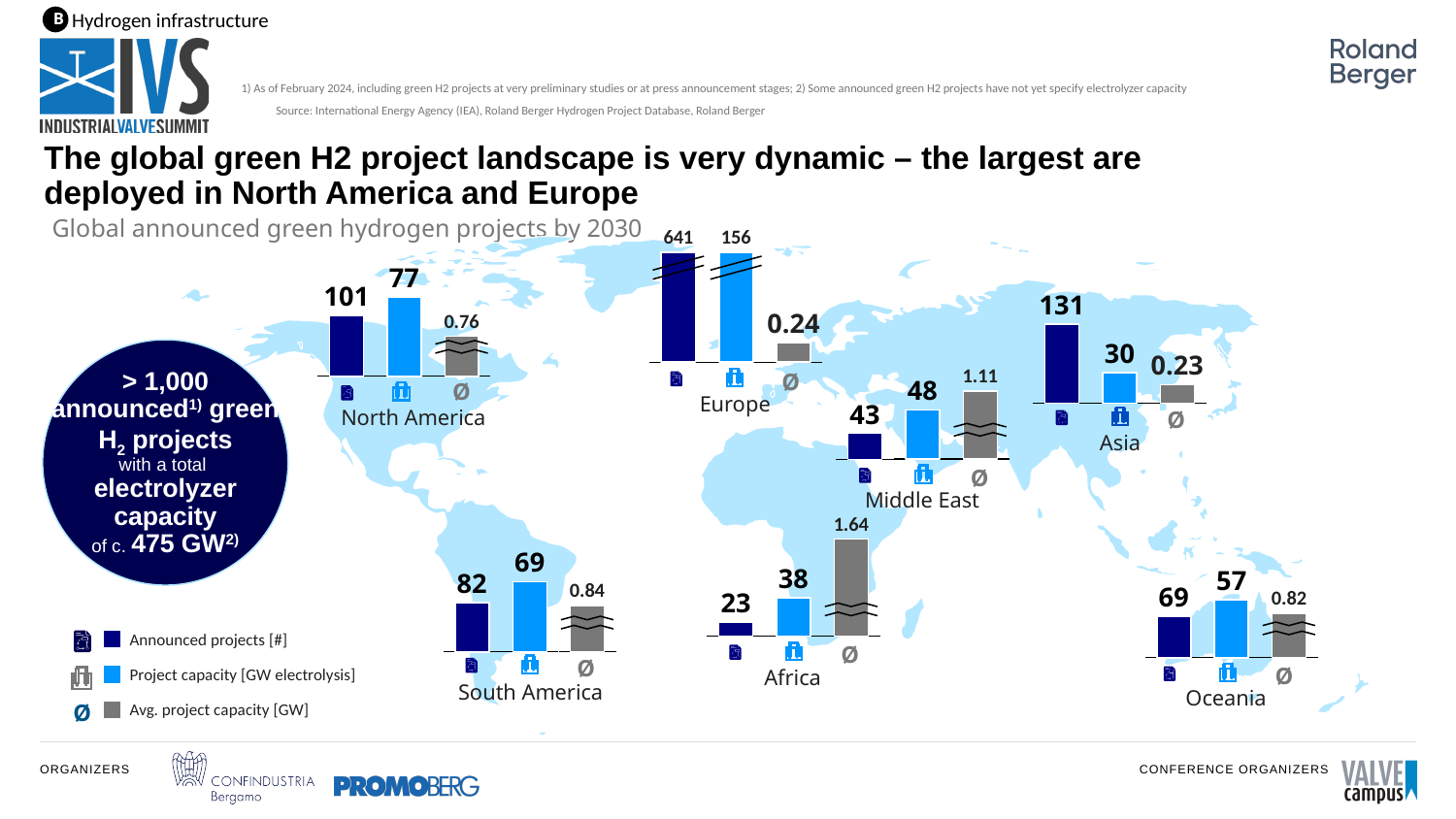
How many regions have their own bar chart on the map? 7 What is the average project capacity in GW shown for Africa? 1.64 How many series does the legend list? 3 Which region has the lowest number of announced projects? Africa Which region has the highest number of announced projects? Europe What is the title of the chart shown on the map? Global announced green hydrogen projects by 2030 What is the project capacity in GW electrolysis shown for North America? 77 Which region has the highest average project capacity? Africa What is the difference between the number of announced projects in Asia and in North America? 30 Which is larger: the project capacity of the Middle East or of Asia? Middle East What kind of chart is used for each region on the map? Bar chart How many announced green hydrogen projects are shown for Europe? 641